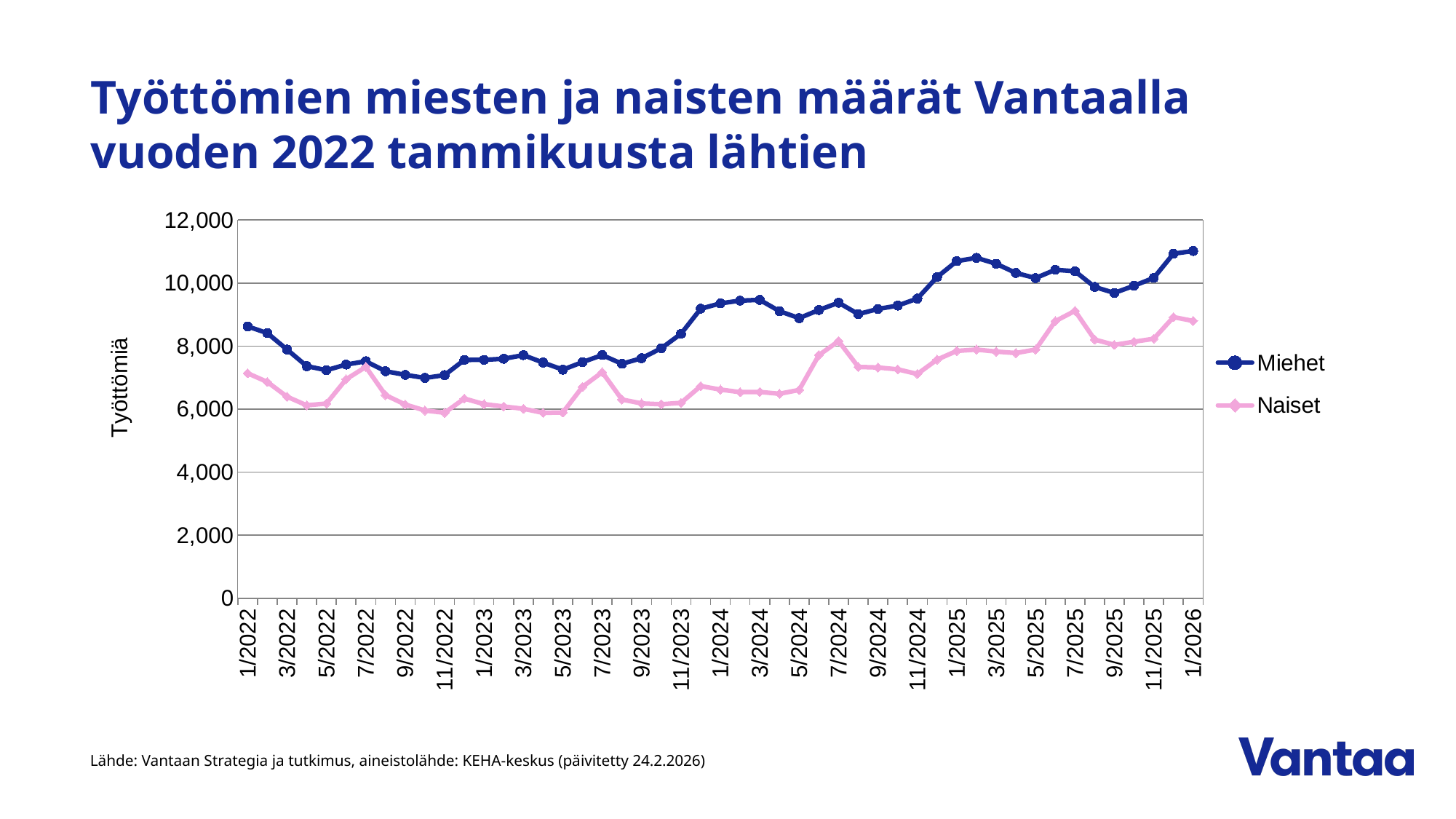
Which is larger in 1/2024, the value for Miehet or the value for Naiset? Miehet Is the value for Naiset in 7/2025 greater or less than 8,000? greater Is the value for Naiset in 1/2022 greater or less than 6,000? greater How many series does the legend list? 2 Is the value for Miehet in 9/2022 greater or less than 8,000? less Which series has the higher values throughout the period, Miehet or Naiset? Miehet Overall, does the Miehet series rise or fall from 1/2022 to 1/2026? rise What is the label on the vertical axis? Työttömiä What kind of chart is shown on the slide? Line chart What are the two series named in the legend? Miehet and Naiset